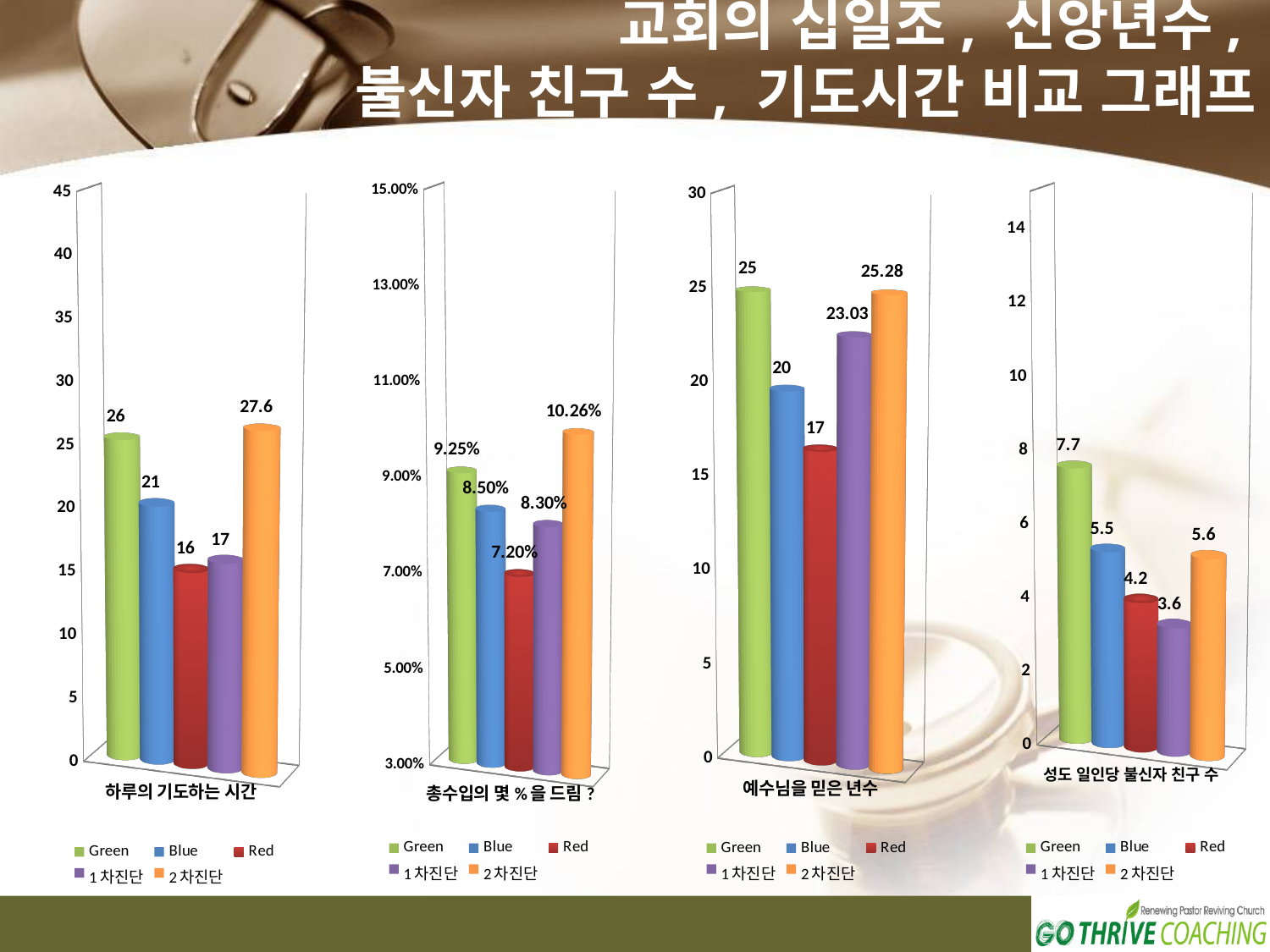
In the chart titled '성도 일인당 불신자 친구 수', what is the value for Red? 4.2 In the chart titled '예수님을 믿은 년수', what is the difference between the Green value and the Blue value? 5 How many series does the legend of the chart titled '하루의 기도하는 시간' list? 5 In the chart titled '총수입의 몇 %을 드림?', which is larger, the Blue value or the 1차진단 value? Blue In the chart titled '하루의 기도하는 시간', which series has the highest value? 2차진단 In the chart titled '성도 일인당 불신자 친구 수', which series has the lowest value? 1차진단 What kind of chart is the chart titled '예수님을 믿은 년수'? bar chart In the chart titled '총수입의 몇 %을 드림?', which series has the lowest value? Red In the chart titled '하루의 기도하는 시간', what is the value for Green? 26 In the chart titled '총수입의 몇 %을 드림?', what is the value for 2차진단? 10.26% In the chart titled '하루의 기도하는 시간', what is the difference between the 2차진단 value and the Red value? 11.6 In the chart titled '예수님을 믿은 년수', what is the value for 1차진단? 23.03